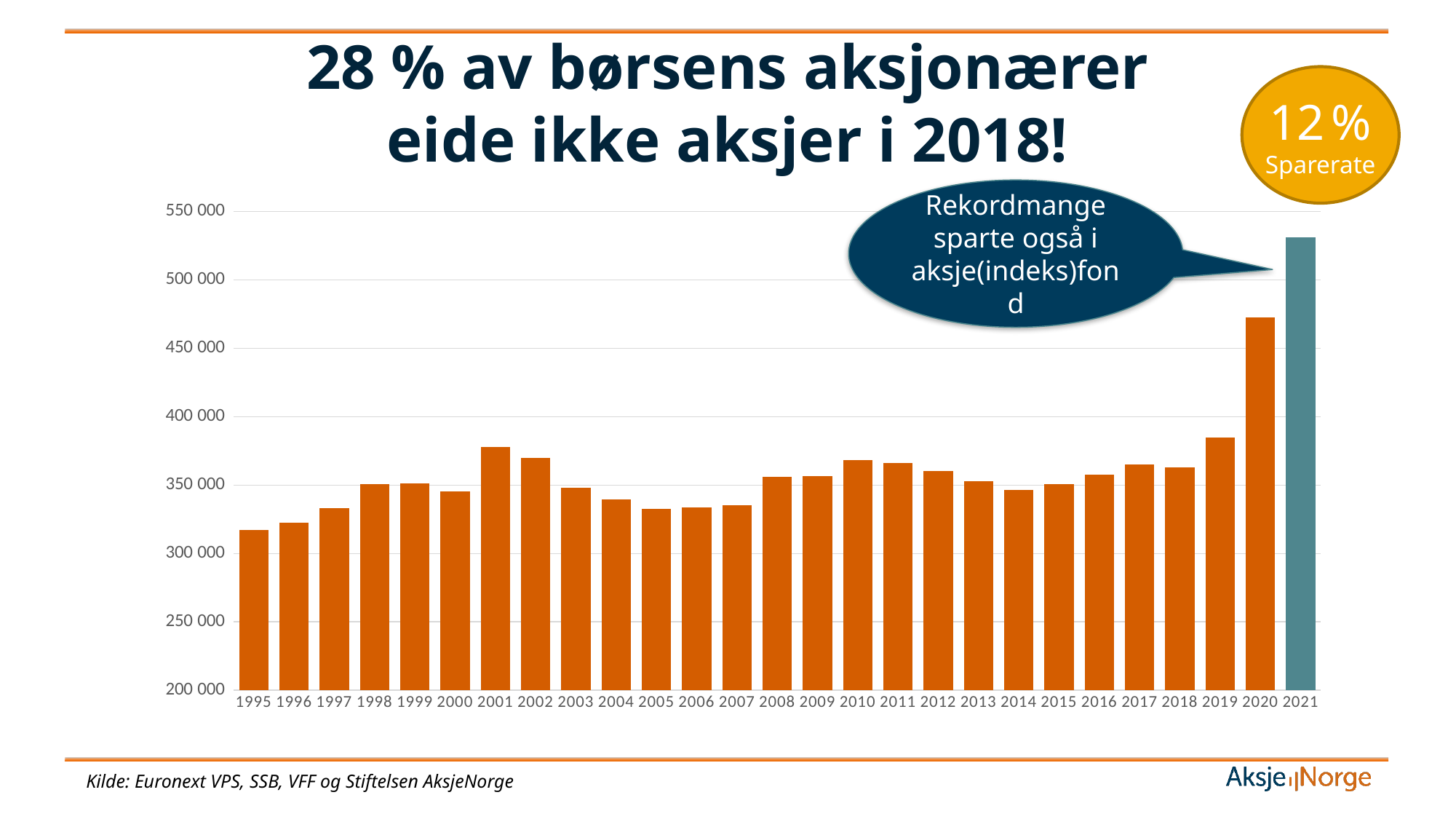
Do the values rise or fall from 2018 to 2021? Rise Is the value for 2020 greater or less than 450 000? greater Which is larger, the value for 2019 or the value for 2020? 2020 Is the value for 2001 greater or less than 400 000? less Is the value for 2005 greater or less than 350 000? less What colour is the bar for 2021, which differs from the other bars? Teal (blue-green) How many years (bars) are plotted on the chart? 27 What kind of chart is shown on the slide? Bar chart Which year has the highest value on the chart? 2021 Which year has the lowest value on the chart? 1995